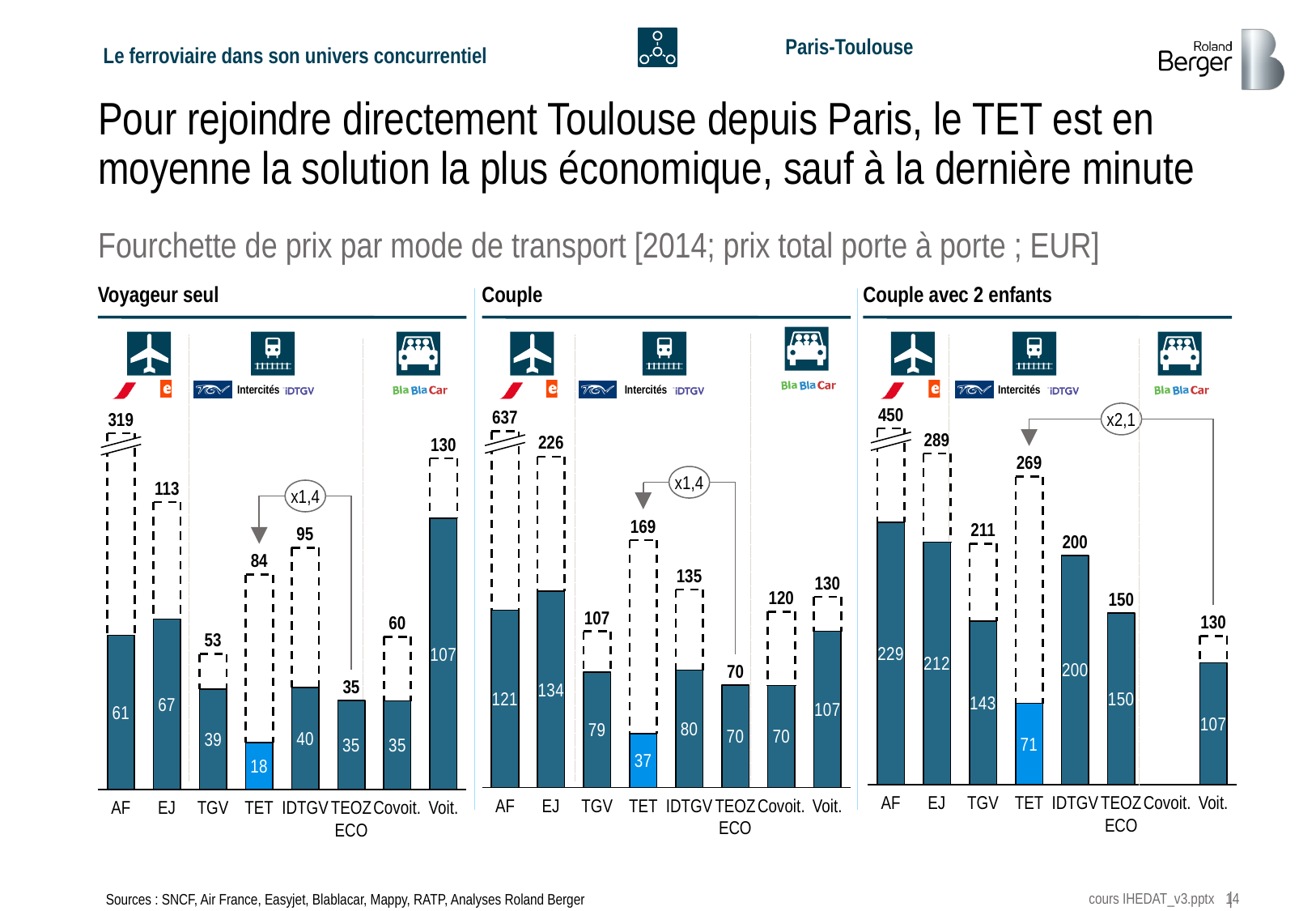
In the 'Voyageur seul' chart, what is the maximum price shown for AF? 319 In the 'Voyageur seul' chart, which mode has the lowest minimum price? TET In the 'Couple' chart, what is the difference between the maximum and minimum price for TET? 132 In the 'Couple' chart, which mode has the highest maximum price? AF What type of chart is used in the 'Voyageur seul' panel? Bar chart In the 'Couple' chart, what is the maximum price shown for EJ? 226 In the 'Voyageur seul' chart, which is larger: the minimum price for EJ or the minimum price for AF? EJ In the 'Voyageur seul' chart, what is the minimum price shown for TET? 18 In the 'Couple avec 2 enfants' chart, what is the minimum price shown for TGV? 143 What multiplier is shown in the callout above TET in the 'Couple avec 2 enfants' chart? x2,1 How many transport modes are labelled on the x axis of the 'Couple' chart? 8 In the 'Couple avec 2 enfants' chart, what is the difference between the maximum price for TET and the maximum price for Voit.? 139